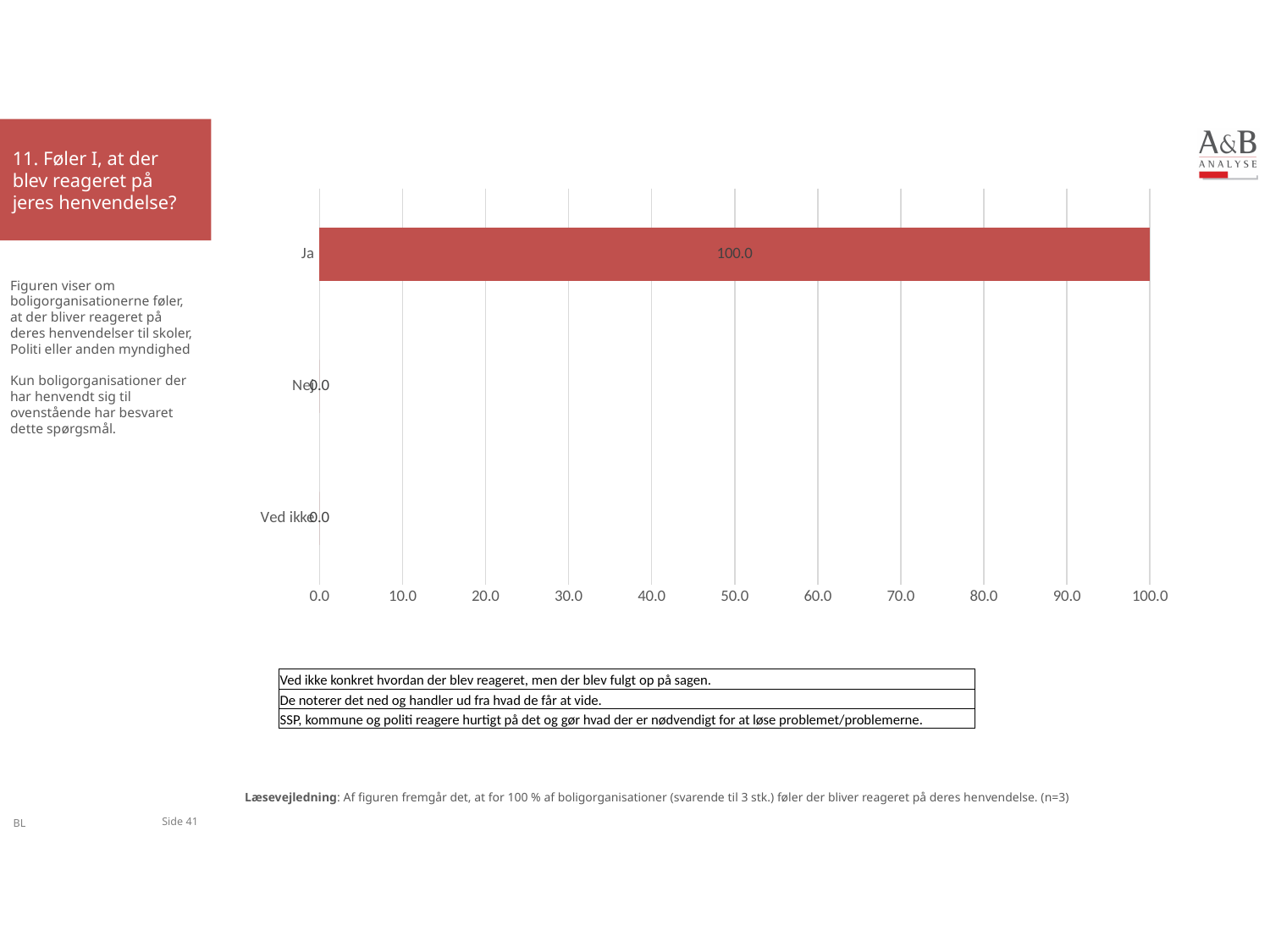
What is the difference between the values for "Ja" and "Nej"? 100.0 Is the value for "Ja" greater or less than 50.0? greater How many categories are shown on the chart? 3 Which category has the highest value? Ja What is the maximum value shown on the x axis? 100.0 What is the value for "Ved ikke"? 0.0 What is the value for "Ja"? 100.0 What colour is the bar for "Ja"? red What is the value for "Nej"? 0.0 What kind of chart is shown on the slide? bar chart Which is larger, the value for "Ja" or the value for "Ved ikke"? Ja